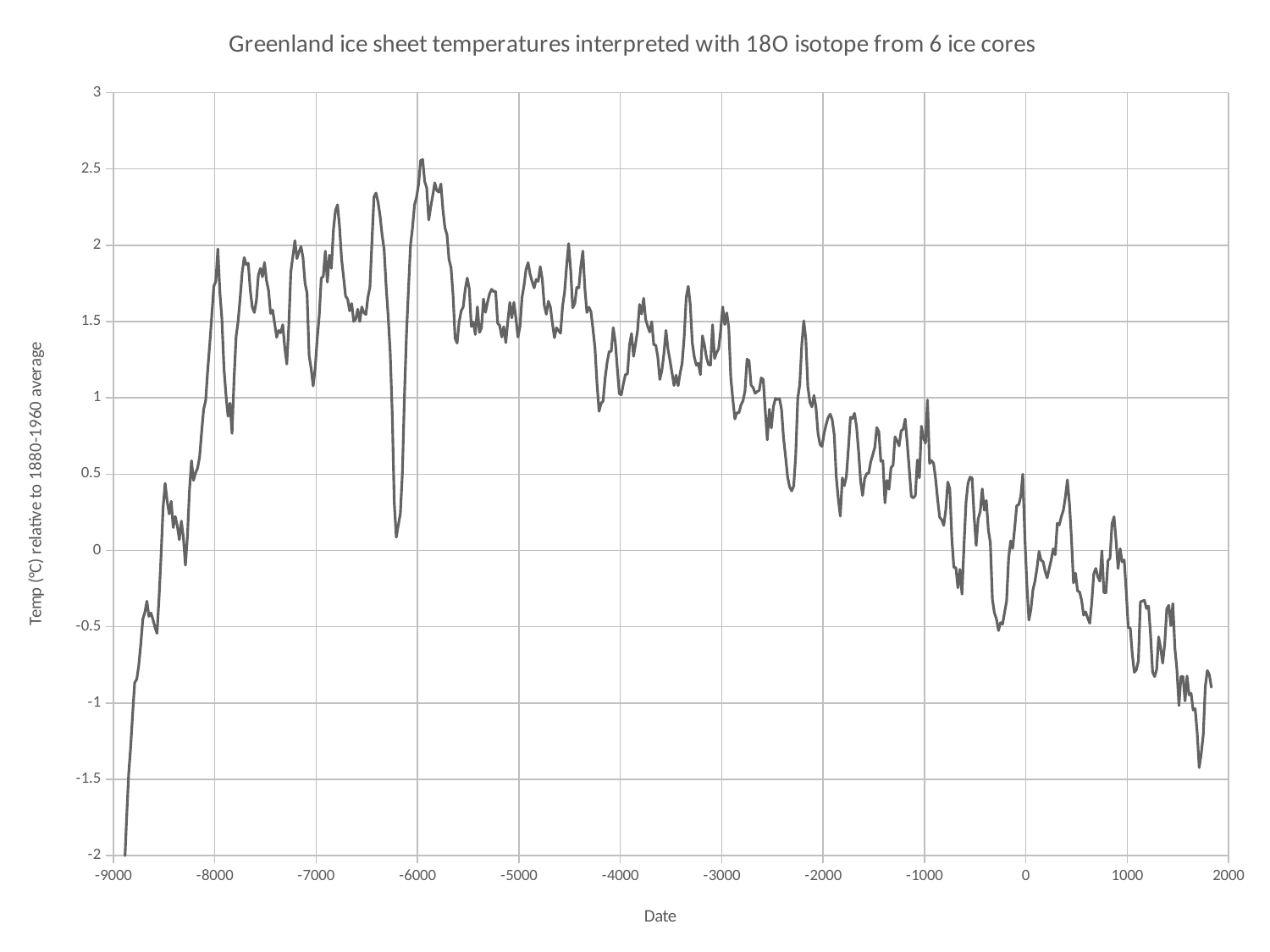
Do the values rise or fall along the x axis from -9000 to -8000? rise Is the sharp dip in the line just before -6000 greater or less than 0.5? less Is the lowest value of the line at the left end or the right end of the chart? left end Overall, do the values rise or fall along the x axis from -6000 to 2000? fall Is the value at the right end of the line, near 1800, greater or less than 0? less Which is larger, the value near -6000 or the value near 1000? the value near -6000 Is the value at -5000 greater or less than 1? greater What is the label on the vertical axis of the chart? Temp (°C) relative to 1880-1960 average What is the title of the chart? Greenland ice sheet temperatures interpreted with 18O isotope from 6 ice cores What kind of chart is shown on the slide? line chart